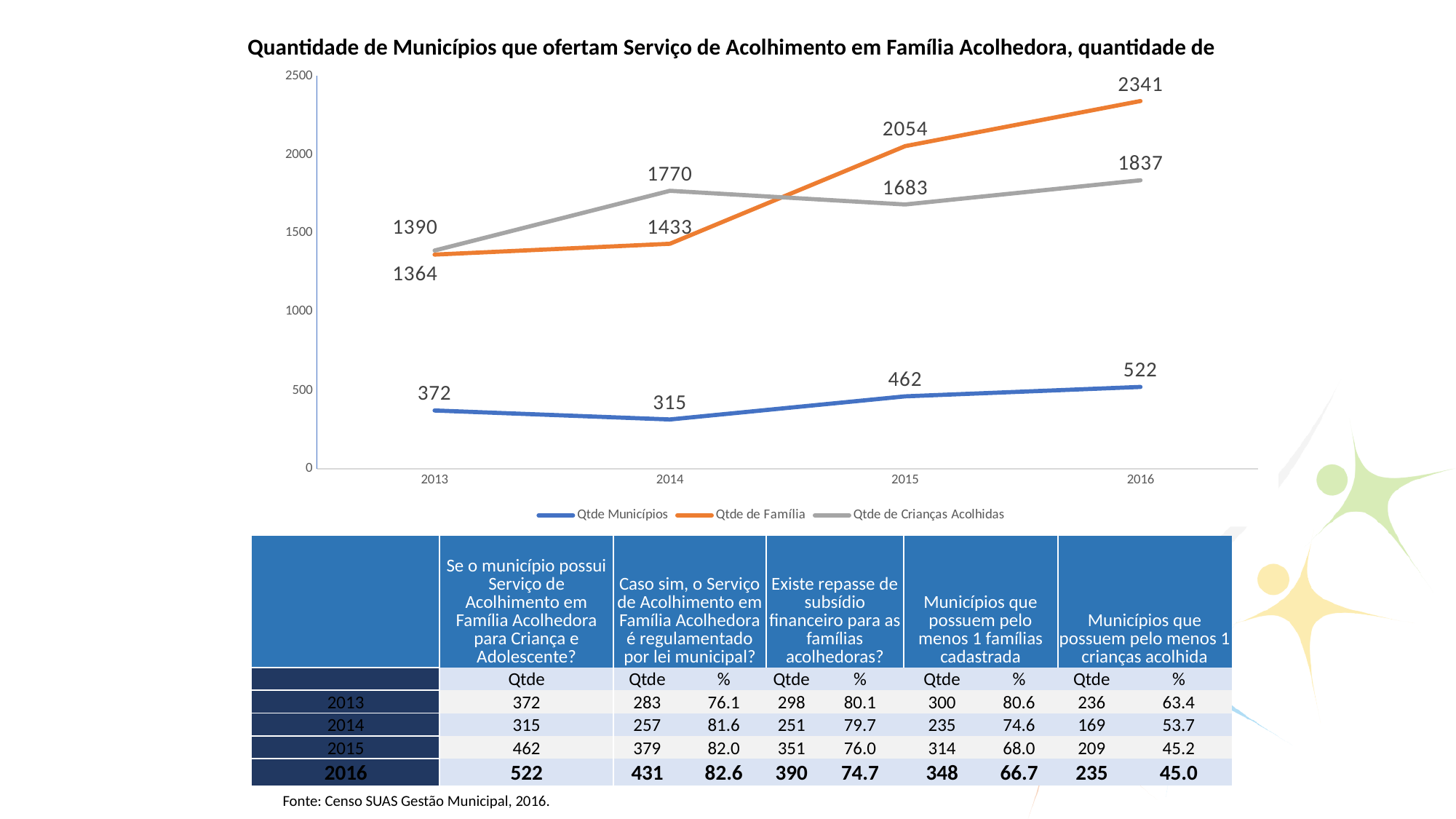
What is the value of Qtde de Família in 2016? 2341 What kind of chart is shown on the slide? line chart What is the value of Qtde de Crianças Acolhidas in 2015? 1683 What is the difference between Qtde de Família in 2016 and in 2015? 287 Does Qtde de Família rise or fall from 2013 to 2016? rise In which year is Qtde Municípios lowest? 2014 Which colour is used for the Qtde Municípios line? blue Which is larger in 2014: Qtde de Família or Qtde de Crianças Acolhidas? Qtde de Crianças Acolhidas What is the value of Qtde Municípios in 2014? 315 How many years are plotted along the x axis of the chart? 4 In which year is Qtde de Família highest? 2016 How many series does the chart legend list? 3